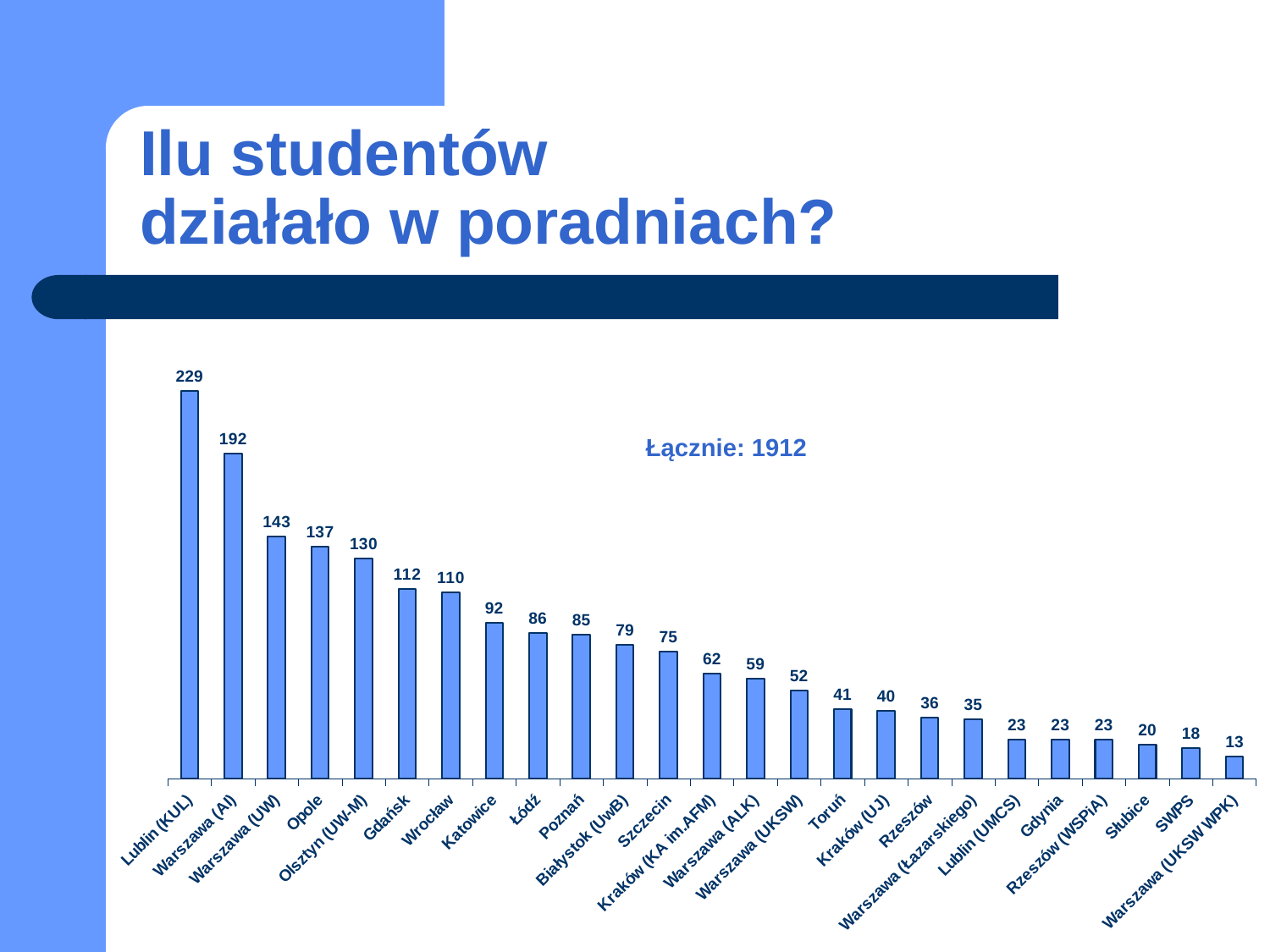
Which category has the highest value? Lublin (KUL) What kind of chart is shown on the slide? Bar chart Which category has the lowest value? Warszawa (UKSW WPK) What is the value for Gdańsk? 112 What is the difference between the values for Katowice and Szczecin? 17 What total is stated in the text annotation on the chart ("Łącznie")? 1912 Do the values rise or fall from left to right along the x axis? Fall What is the value for Toruń? 41 Which is larger, the value for Opole or the value for Olsztyn (UW-M)? Opole What is the difference between the values for Warszawa (AI) and Warszawa (UW)? 49 How many categories are plotted on the chart? 25 How many students are shown for Lublin (KUL)? 229